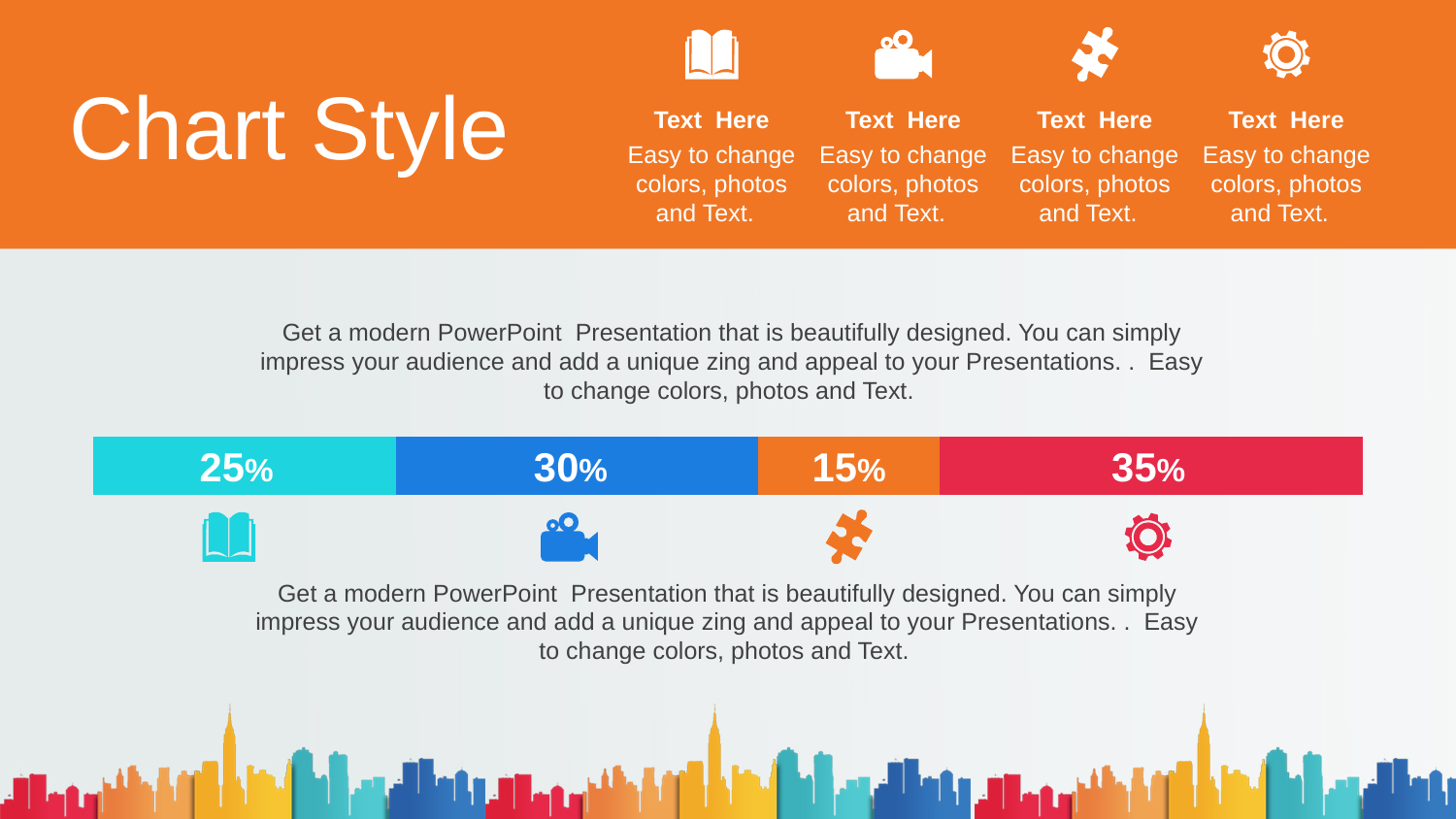
What kind of chart is shown on the slide? bar chart Which segment of the bar has the highest value? the red segment (35%) Which is larger, the blue segment or the orange segment? the blue segment What is the difference between the red segment and the teal segment? 10% How many segments does the stacked bar contain? 4 Which icon appears below the orange 15% segment? a puzzle piece Which segment of the bar has the lowest value? the orange segment (15%) What is the total of all four segments of the stacked bar? 100% What is the value of the orange (third) segment of the bar? 15% What is the value of the blue (second) segment of the bar? 30% What is the value of the teal (first) segment of the bar? 25% What is the value of the red (fourth) segment of the bar? 35%